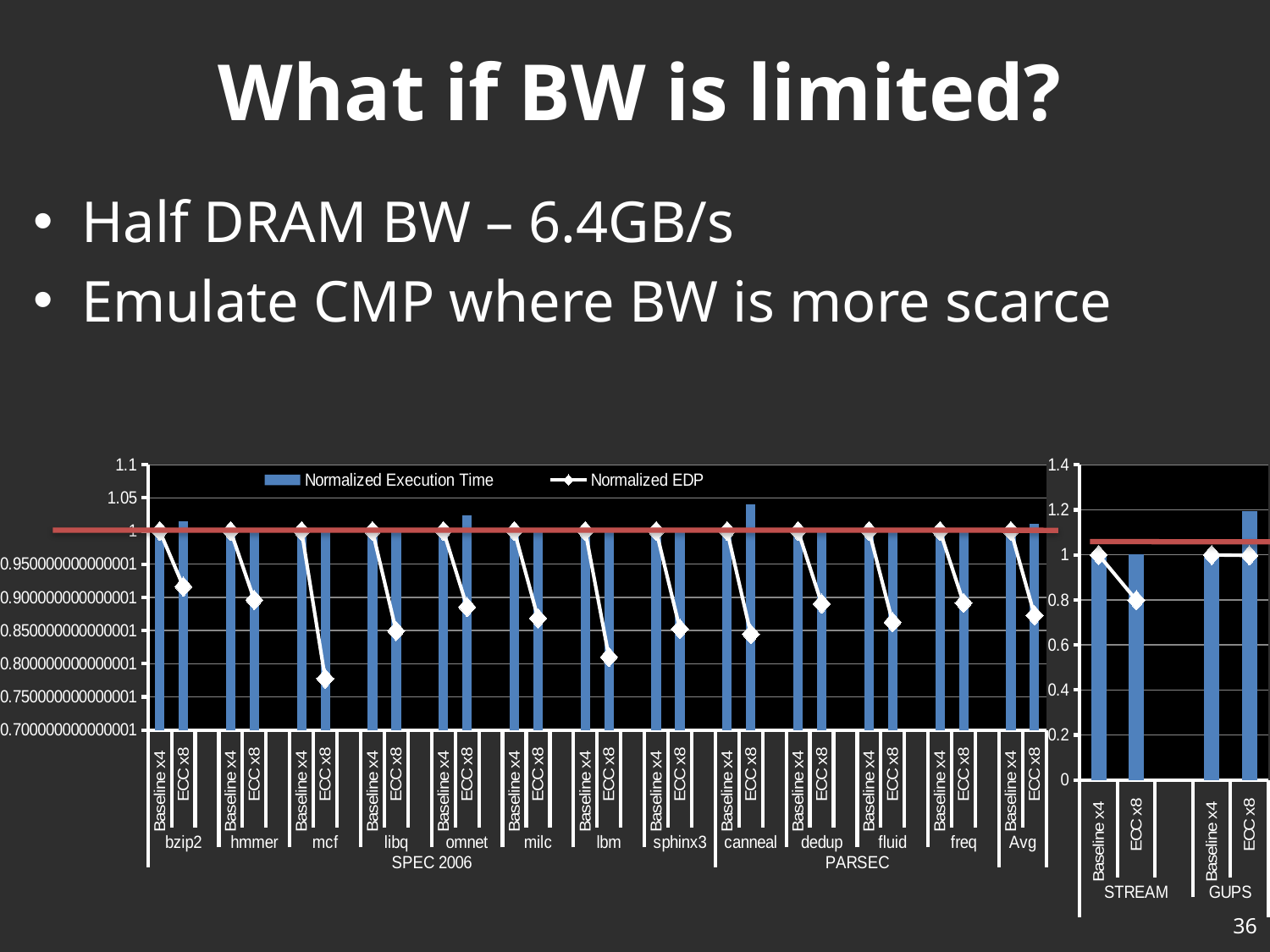
In the right chart, how many bars are plotted? 4 In the left chart, what are the two series named in the legend? Normalized Execution Time and Normalized EDP In the left chart, how many benchmark groups are shown along the x axis (including Avg)? 13 In the left chart, is the Normalized EDP for ECC x8 under mcf greater or less than 0.8? less In the left chart, is the Normalized Execution Time for ECC x8 under canneal greater or less than 1? greater In the left chart, what is the Normalized Execution Time for Baseline x4 under bzip2? 1 In the left chart, which is larger: the Normalized EDP for ECC x8 under hmmer or under mcf? hmmer In the left chart, how many series does the legend list? 2 In the left chart, which benchmark has the lowest Normalized EDP for ECC x8? mcf In the right chart, is the Normalized Execution Time for ECC x8 under GUPS greater or less than 1? greater What kind of chart is the right chart (STREAM / GUPS)? combination bar and line chart In the left chart, which series is drawn as bars? Normalized Execution Time